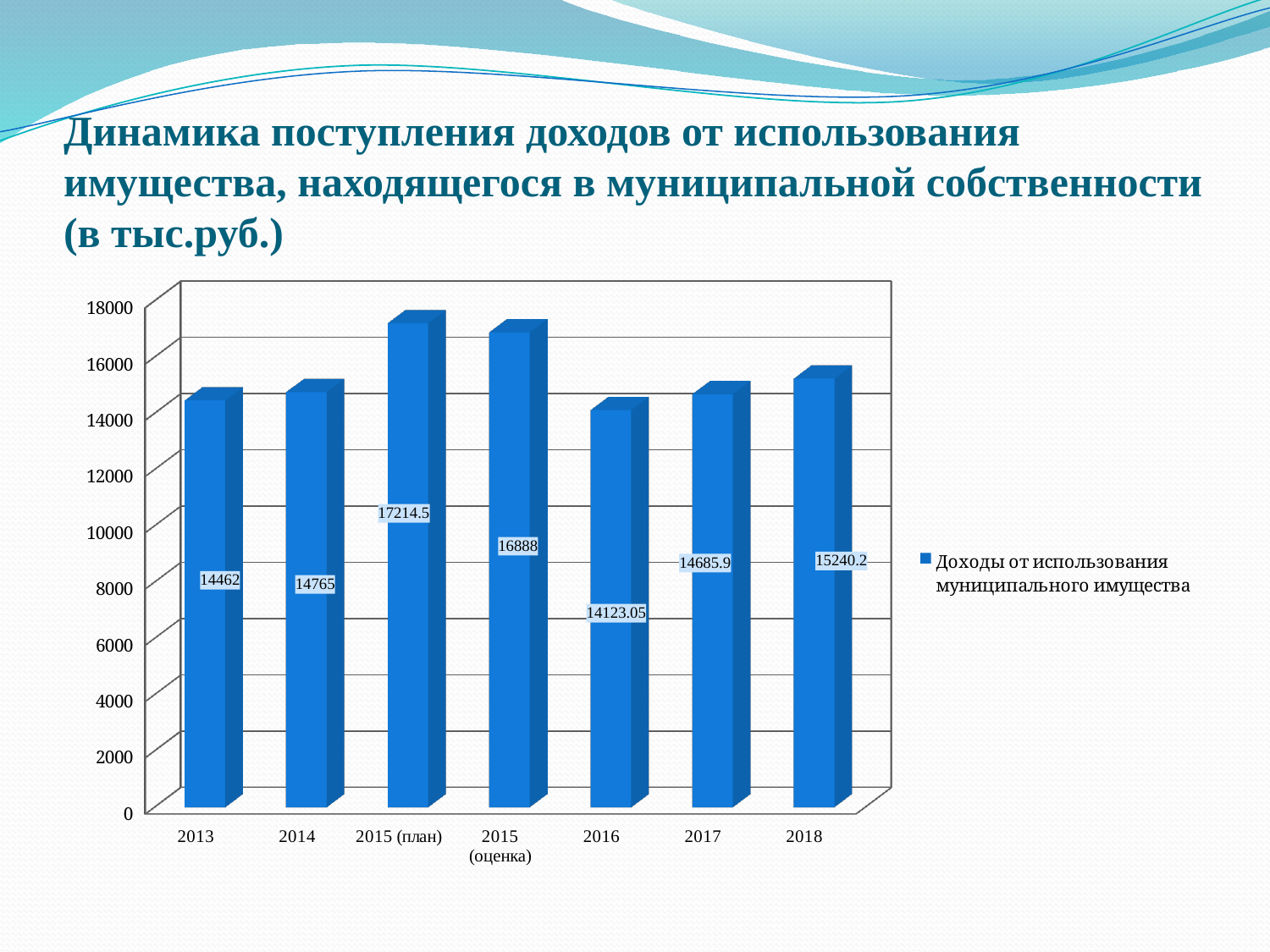
What kind of chart is shown on the slide? bar chart Which is larger, the value for 2018 or the value for 2016? 2018 Which category has the highest value? 2015 (план) Is the value for 2015 (план) greater or less than 16000? greater Which category has the lowest value? 2016 How many categories are shown on the x axis? 7 What is the difference between the values for 2018 and 2017? 554.3 What is the value for 2013? 14462 What is the value for 2016? 14123.05 What is the value for 2015 (оценка)? 16888 What is the value for 2018? 15240.2 What is the difference between the values for 2015 (план) and 2015 (оценка)? 326.5